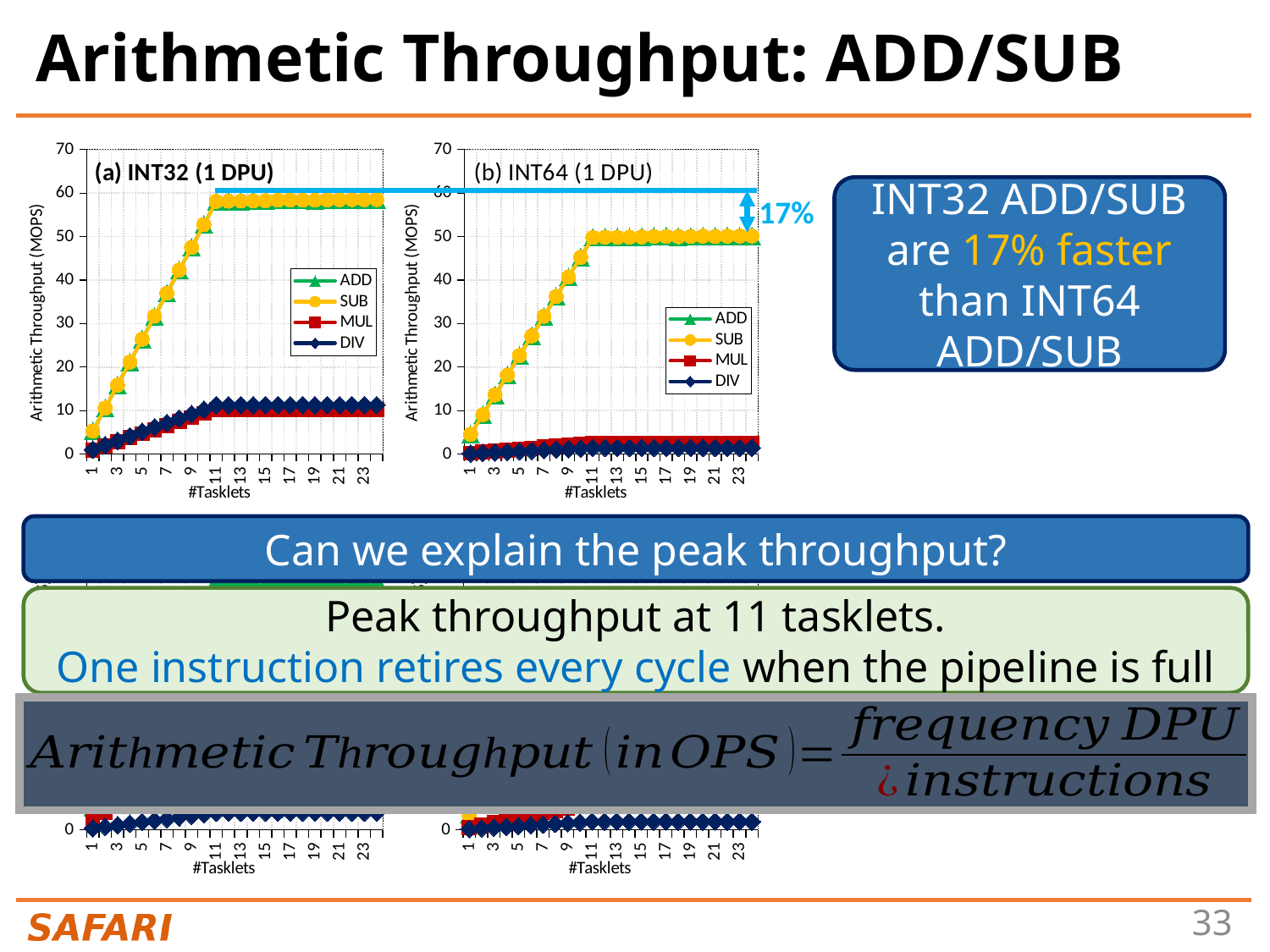
In the (a) INT32 (1 DPU) chart, is the DIV value at 23 tasklets greater or less than 20? less In the (b) INT64 (1 DPU) chart, is the ADD value at 5 tasklets greater or less than 30? less In the (a) INT32 (1 DPU) chart, is the ADD value at 23 tasklets greater or less than 50? greater Is the peak ADD throughput higher in the (a) INT32 (1 DPU) chart or the (b) INT64 (1 DPU) chart? (a) INT32 (1 DPU) In the (a) INT32 (1 DPU) chart, which is higher at 23 tasklets, ADD or MUL? ADD What kind of chart is the (a) INT32 (1 DPU) chart? line chart What is the y-axis label of the (b) INT64 (1 DPU) chart? Arithmetic Throughput (MOPS) How many series does the legend of the (b) INT64 (1 DPU) chart list? 4 What are the legend entries in the (a) INT32 (1 DPU) chart? ADD, SUB, MUL, DIV In the (a) INT32 (1 DPU) chart, does the ADD series rise or fall from 1 to 11 tasklets? rise